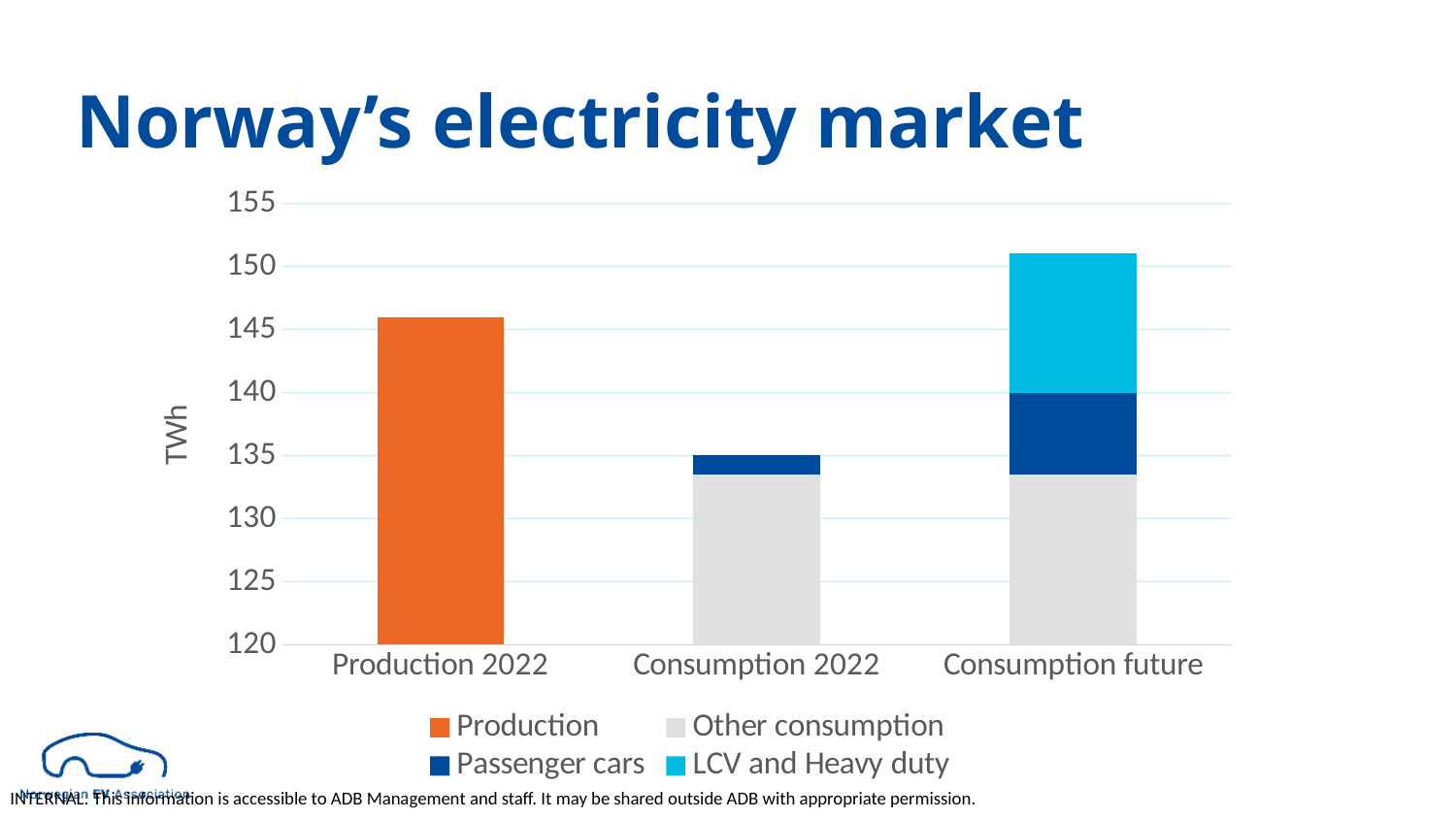
Which category has the lowest total bar? Consumption 2022 Is the value for Production 2022 greater or less than 145? greater Is the total for Consumption future greater or less than 150? greater Which is larger, the bar for Production 2022 or the total bar for Consumption future? Consumption future What unit is shown on the y axis of the chart? TWh Which is larger, the bar for Production 2022 or the total bar for Consumption 2022? Production 2022 What colour represents the Production series in the chart? Orange Is the total for Consumption 2022 greater or less than 140? less How many series does the chart's legend list? 4 What kind of chart is shown on the slide? Stacked bar chart How many categories are shown on the x axis of the chart? 3 Which category has the highest total bar? Consumption future